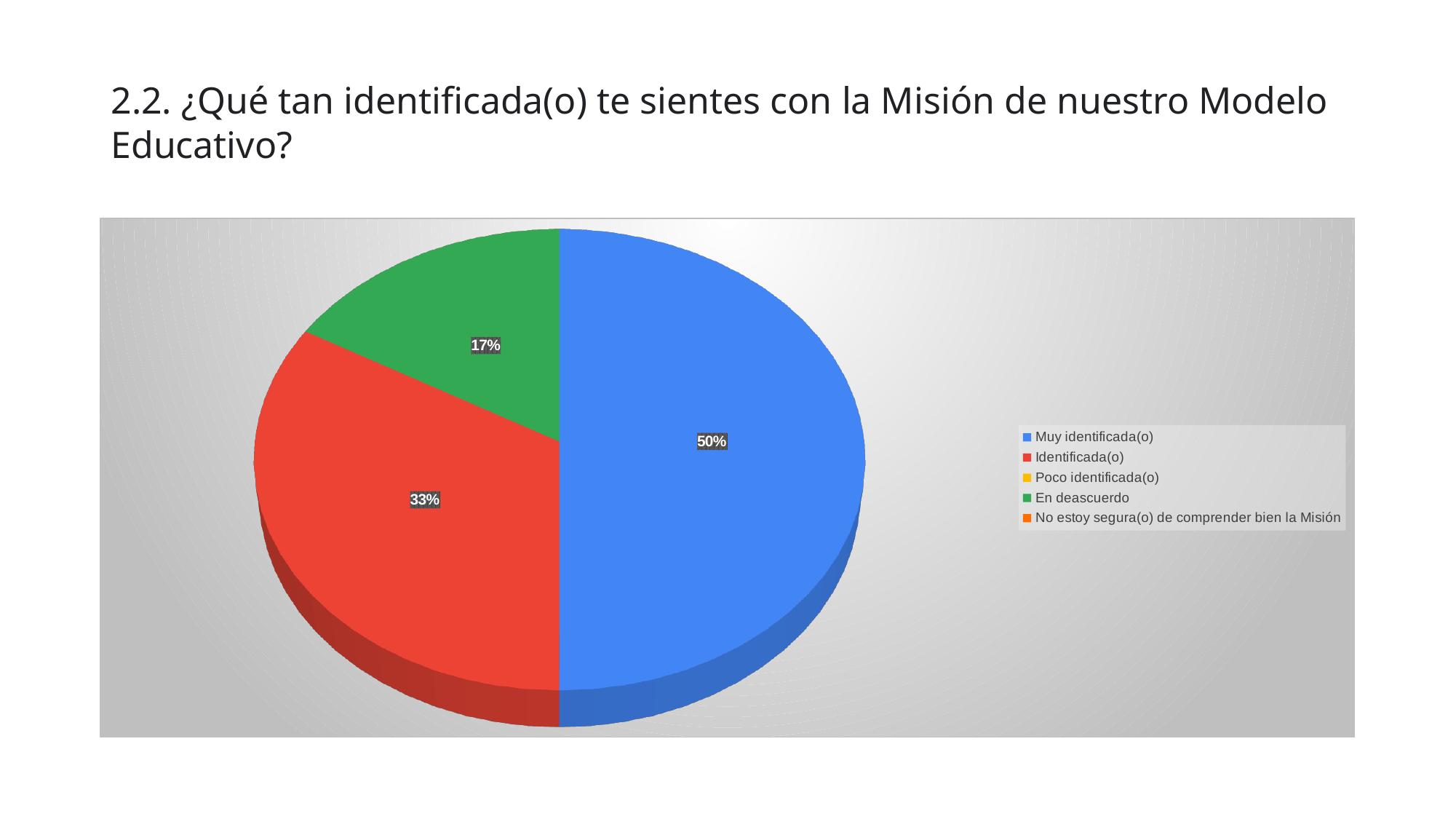
What share of the pie does "Muy identificada(o)" represent? 50% Which is larger, the slice for "Identificada(o)" or the slice for "En deascuerdo"? Identificada(o) What share of the pie does "En deascuerdo" represent? 17% What is the title of the slide? 2.2. ¿Qué tan identificada(o) te sientes con la Misión de nuestro Modelo Educativo? Which of the visible slices is the smallest? En deascuerdo What share of the pie does "Identificada(o)" represent? 33% What colour is the slice for "Muy identificada(o)"? Blue What is the difference in percentage points between "Muy identificada(o)" and "Identificada(o)"? 17 What kind of chart is shown on the slide? Pie chart What is the difference in percentage points between "Identificada(o)" and "En deascuerdo"? 16 How many categories does the legend list? 5 Which category has the largest slice of the pie? Muy identificada(o)